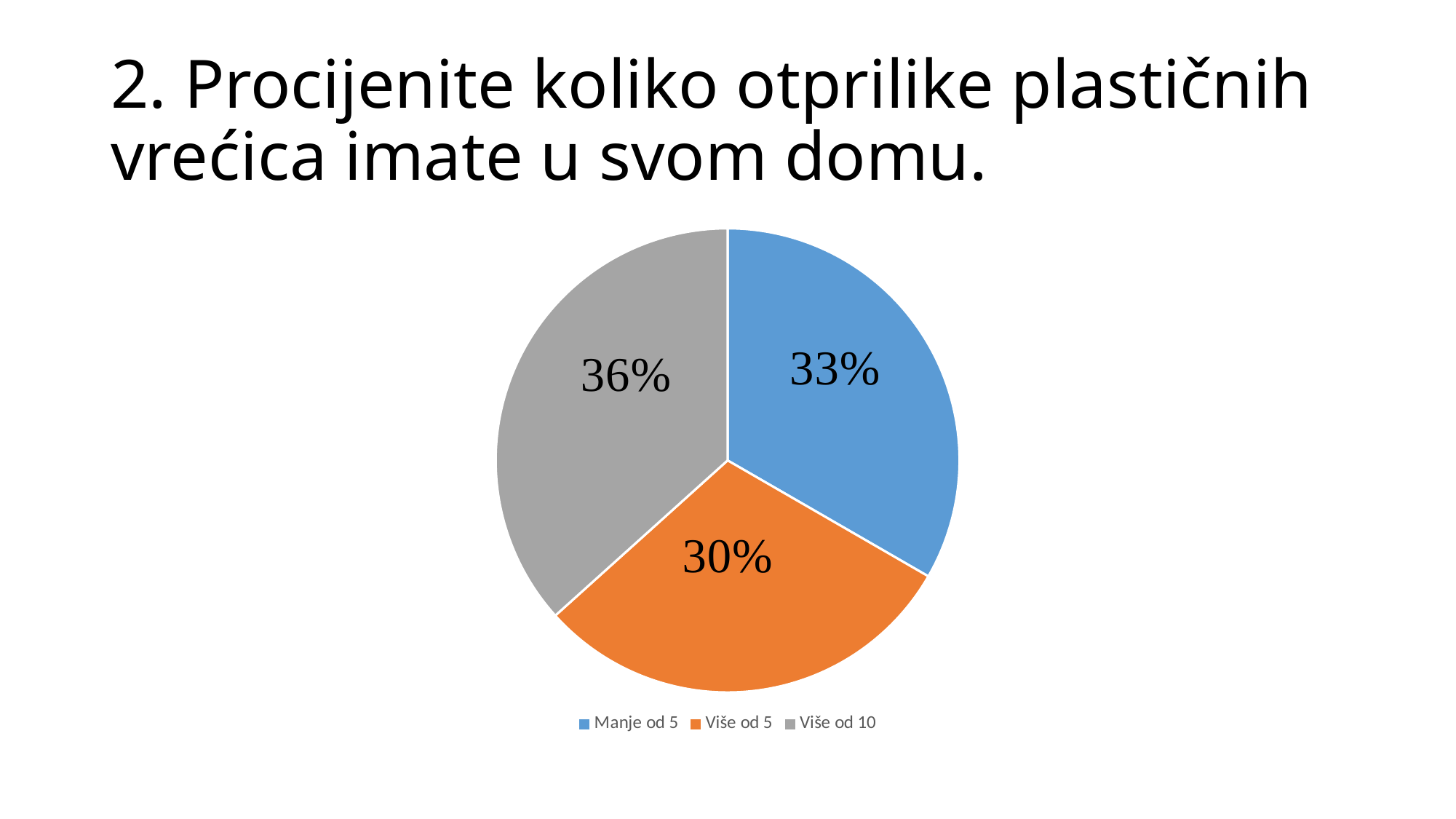
Which is larger, the slice for "Manje od 5" or the slice for "Više od 10"? Više od 10 Which category has the smallest slice of the pie? Više od 5 What share of the pie does "Više od 5" have? 30% What share of the pie does "Manje od 5" have? 33% How many slices does the pie chart have? 3 How many entries does the legend list? 3 Which category has the largest slice of the pie? Više od 10 What is the difference in percentage points between "Više od 10" and "Više od 5"? 6 What is the difference in percentage points between "Manje od 5" and "Više od 5"? 3 What share of the pie does "Više od 10" have? 36% What kind of chart is shown on the slide? pie chart What colour is the slice for "Više od 5"? orange